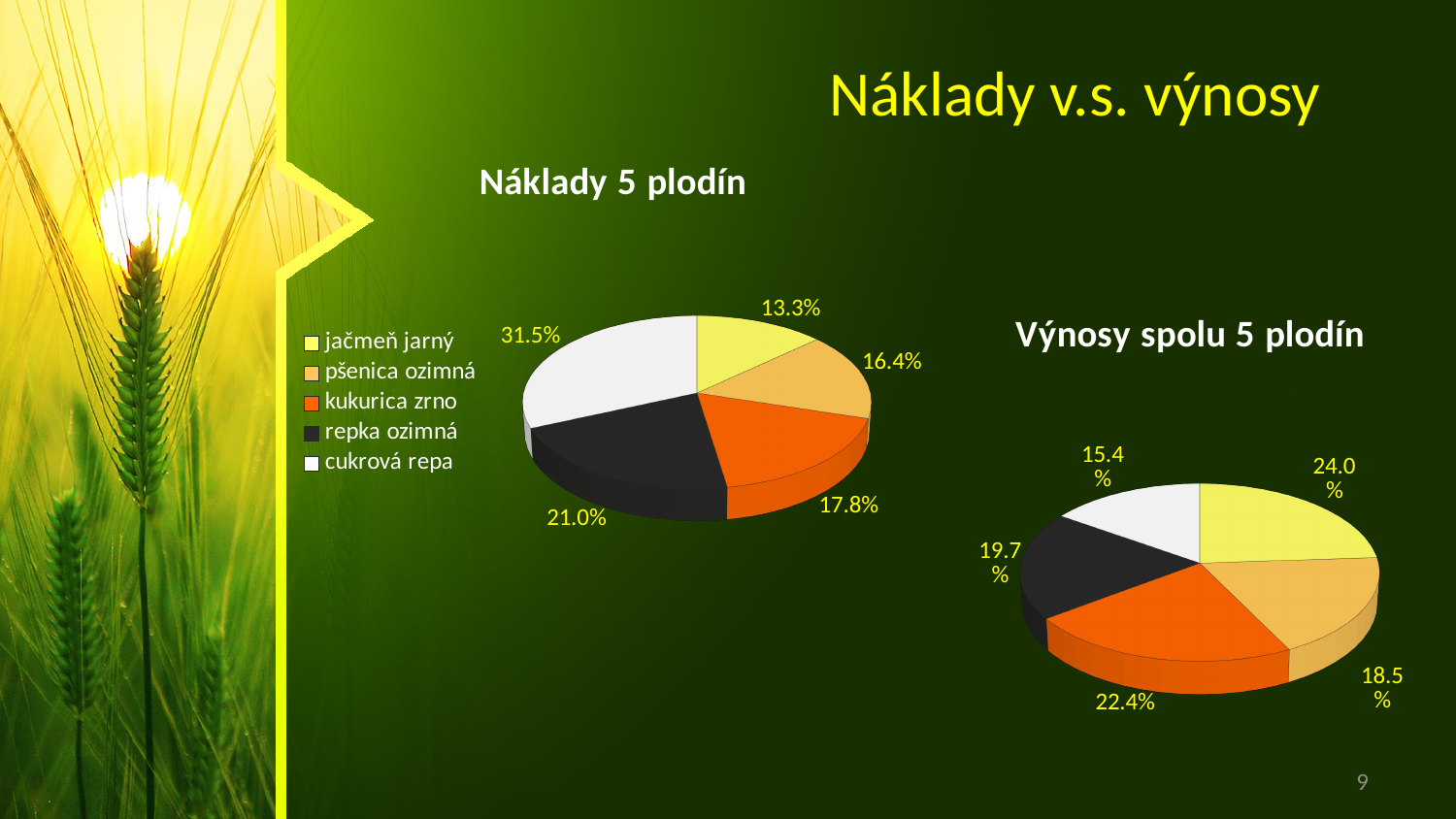
In the 'Výnosy spolu 5 plodín' chart, what is the difference between the orange slice (22.4%) and the light orange slice (18.5%)? 3.9% How many crops does the legend of the 'Náklady 5 plodín' chart list? 5 In the 'Výnosy spolu 5 plodín' chart, what is the value of the white slice? 15.4% How many slices does the 'Výnosy spolu 5 plodín' pie chart have? 5 In the 'Náklady 5 plodín' chart, which crop has the smallest share? jačmeň jarný In the 'Náklady 5 plodín' chart, which has a larger share, kukurica zrno or pšenica ozimná? kukurica zrno In the 'Náklady 5 plodín' chart, which crop has the largest share? cukrová repa In the 'Náklady 5 plodín' chart, what is the difference between the shares of repka ozimná and pšenica ozimná? 4.6% What type of chart is 'Výnosy spolu 5 plodín'? pie chart In the 'Náklady 5 plodín' chart, what share does cukrová repa have? 31.5% In the 'Výnosy spolu 5 plodín' chart, what is the value of the yellow slice? 24.0% In the 'Náklady 5 plodín' chart, what share does jačmeň jarný have? 13.3%